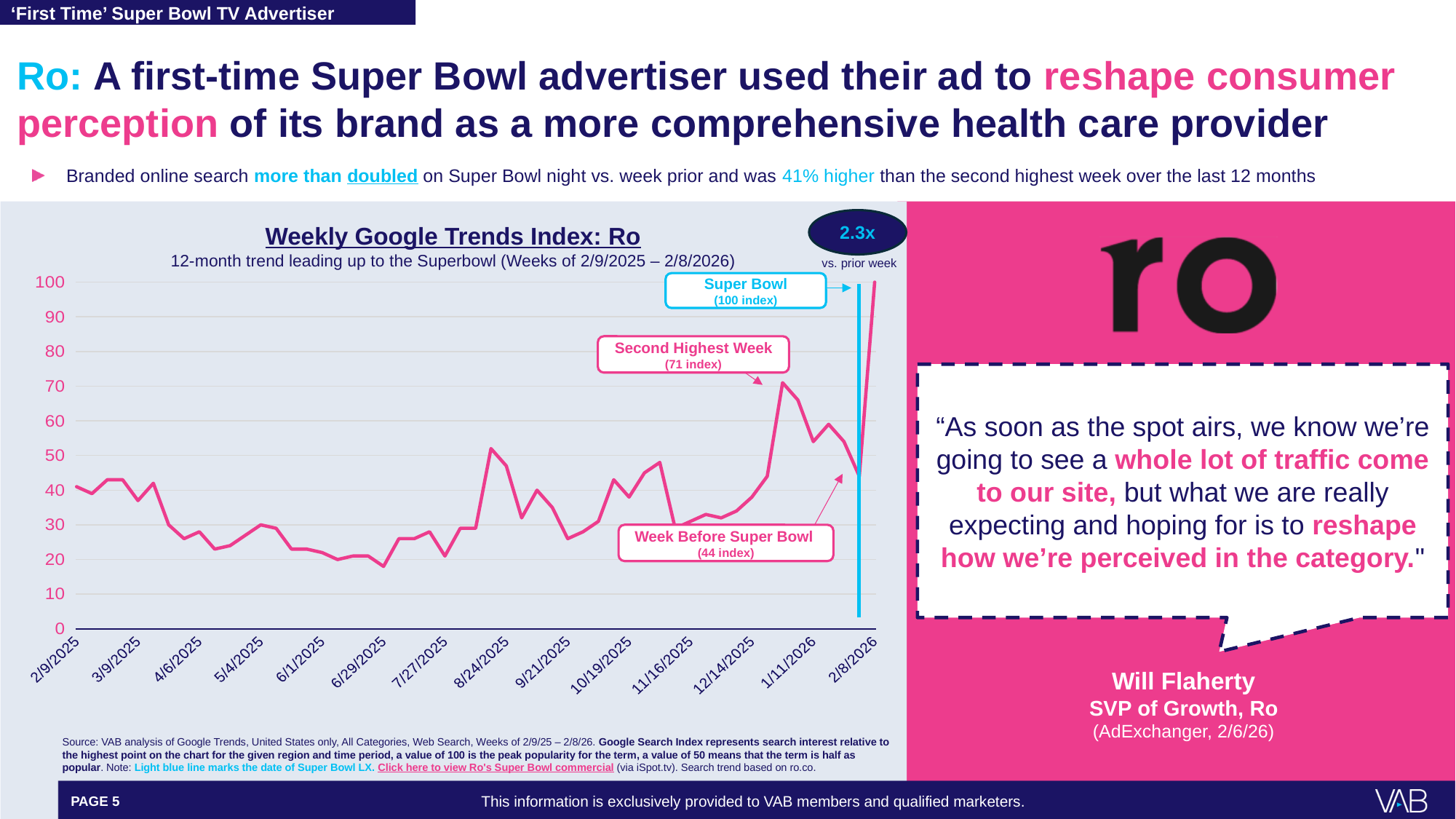
What is the Google Trends index value for the Super Bowl week? 100 index What is the title of the chart? Weekly Google Trends Index: Ro What kind of chart is shown on the slide? line chart How many date labels are shown on the x axis? 14 What is the difference between the Super Bowl week index and the week before Super Bowl index? 56 Is the index value at the week of 2/9/2025 greater or less than 30? greater Which week has the highest Google Trends index on the chart? Super Bowl week (2/8/2026) Is the index value at the week of 6/29/2025 greater or less than 30? less What is the difference between the Super Bowl week index and the second highest week index? 29 What is the index value for the week before the Super Bowl? 44 index What is the index value for the second highest week? 71 index Which is larger, the index for the Super Bowl week or the index for the second highest week? Super Bowl week